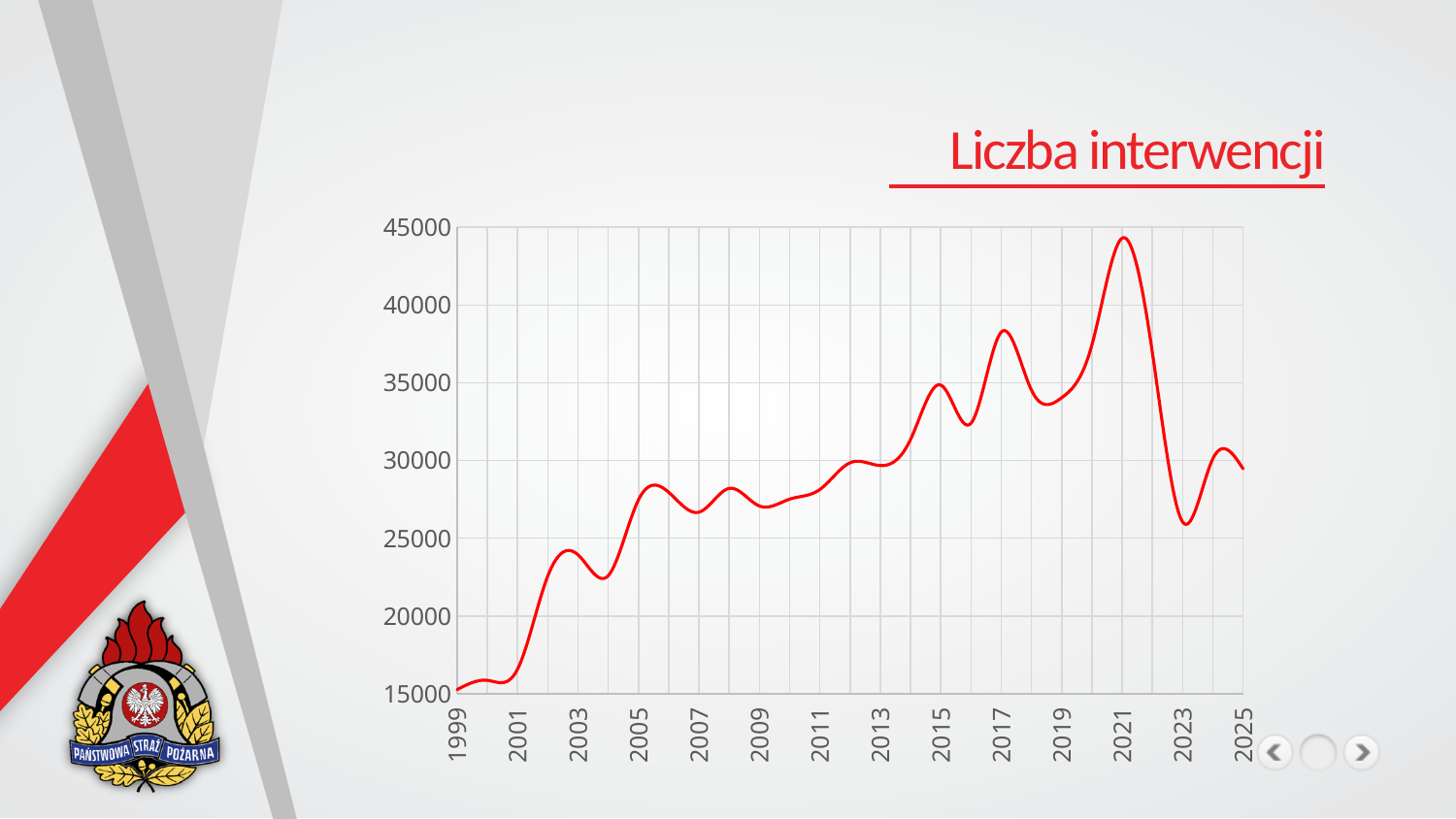
Which year has the higher value, 2017 or 2021? 2021 Is the value for 2009 greater or less than 30000? less In which year does the line have its lowest value? 1999 Is the value for 2015 greater or less than 30000? greater Is the value for 1999 greater or less than 20000? less What is the title of the chart? Liczba interwencji Does the line generally rise or fall between 1999 and 2021? rise In which year does the line reach its highest value? 2021 What kind of chart is shown on the slide? line chart